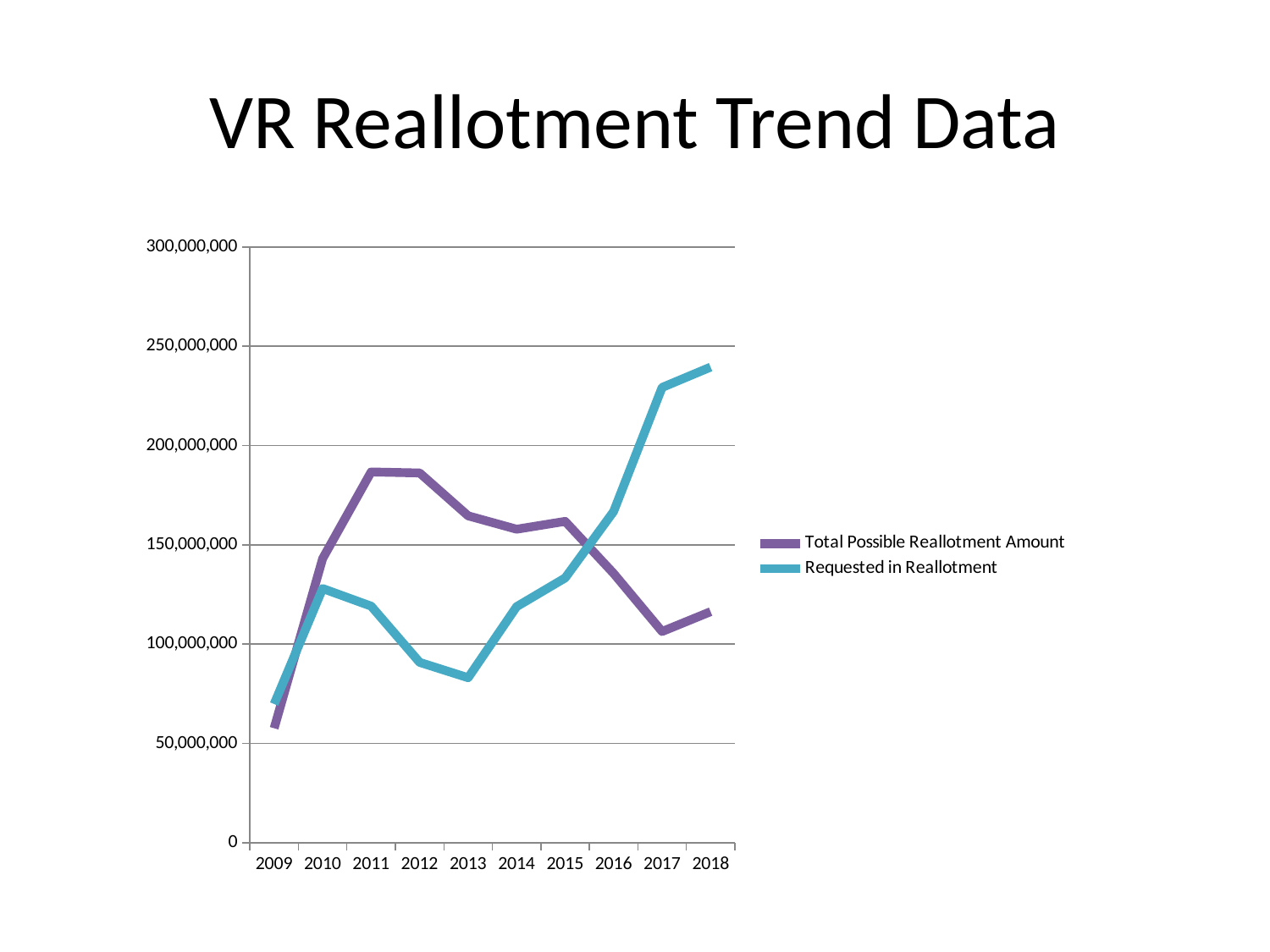
Which series is drawn in purple? Total Possible Reallotment Amount Is the value for Requested in Reallotment in 2013 greater or less than 100,000,000? less In 2012, which series has the larger value, Total Possible Reallotment Amount or Requested in Reallotment? Total Possible Reallotment Amount In 2018, which series has the larger value, Total Possible Reallotment Amount or Requested in Reallotment? Requested in Reallotment In which year is the Total Possible Reallotment Amount lowest? 2009 Is the value for Total Possible Reallotment Amount in 2009 greater or less than 100,000,000? less Is the value for Total Possible Reallotment Amount in 2011 greater or less than 150,000,000? greater How many series does the legend list? 2 What is the title of the chart? VR Reallotment Trend Data How many years are shown on the x axis? 10 What kind of chart is shown on the slide? Line chart